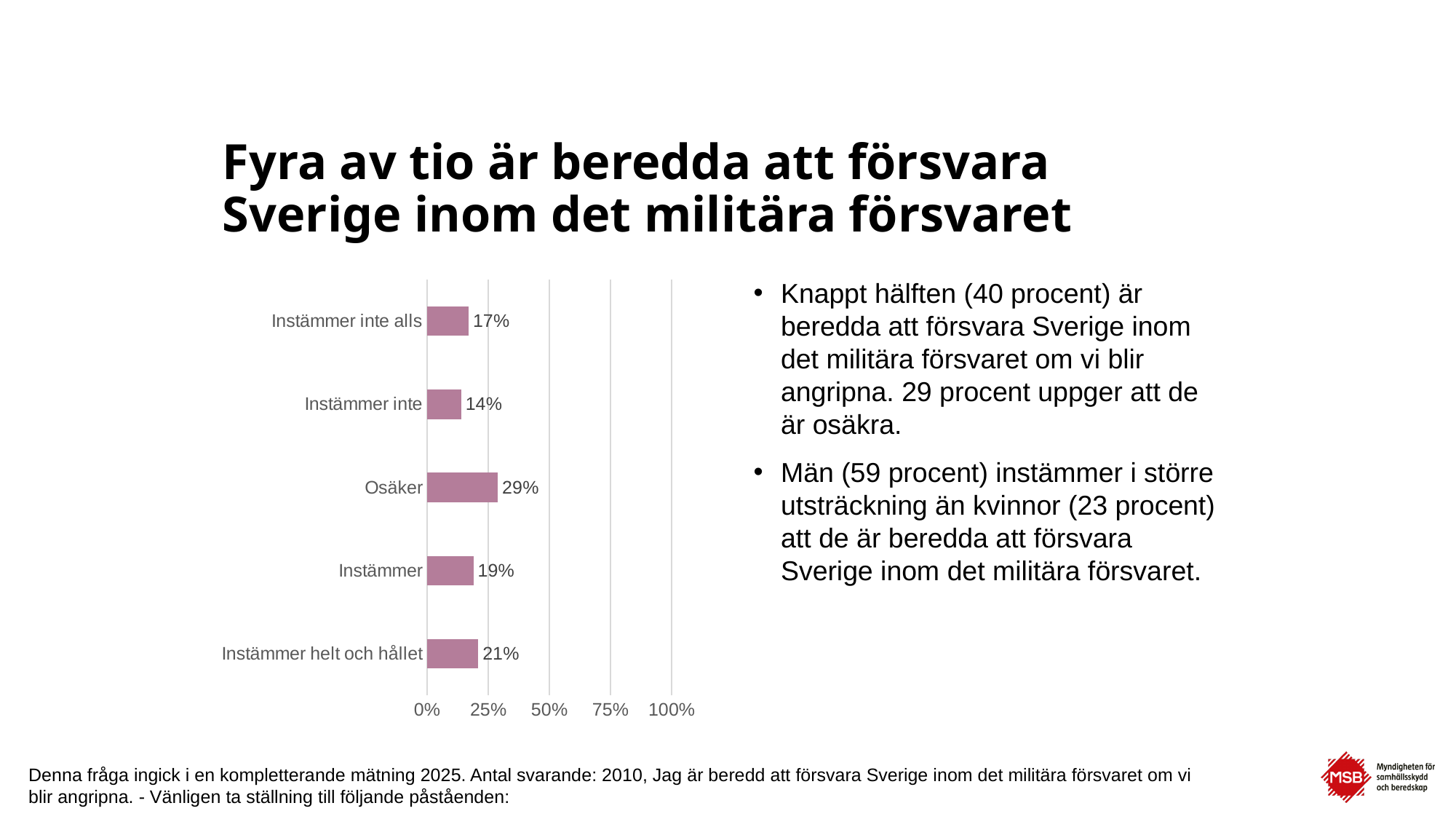
What is the combined value of "Instämmer helt och hållet" and "Instämmer"? 40% What kind of chart is shown on the slide? Bar chart Which category has the lowest value? Instämmer inte What is the difference between the values for "Osäker" and "Instämmer"? 10% Which is larger, the value for "Instämmer helt och hållet" or the value for "Instämmer inte alls"? Instämmer helt och hållet What is the value for "Osäker"? 29% Which category has the highest value? Osäker Is the value for "Osäker" greater or less than 25%? greater How many categories are shown in the chart? 5 What is the value for "Instämmer helt och hållet"? 21% What is the value for "Instämmer inte"? 14% What is the value for "Instämmer inte alls"? 17%